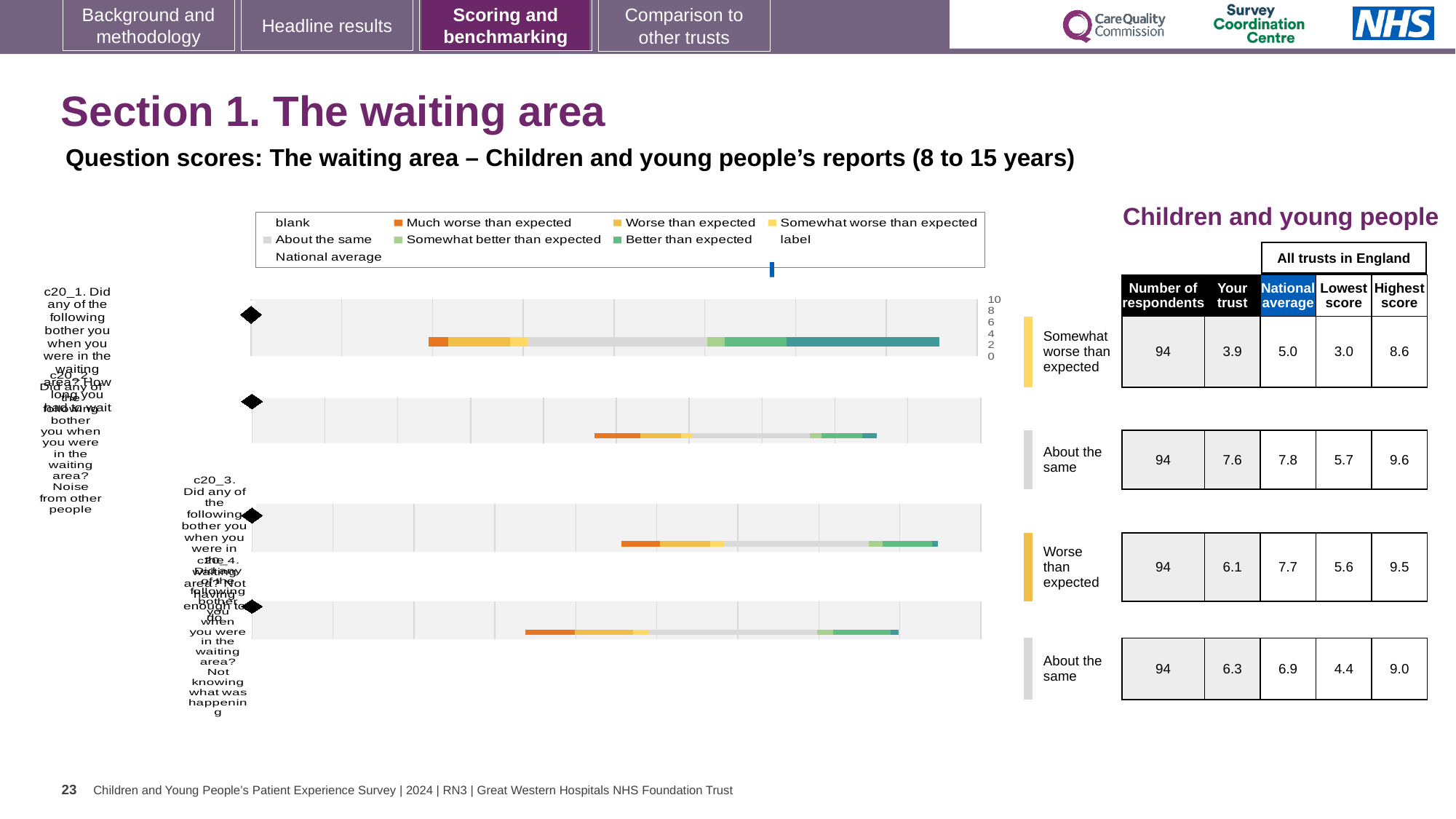
What kind of chart is used to show the score distribution for question c20_1? bar chart In the table beside the charts, what is the national average in the first row (Somewhat worse than expected)? 5.0 In the table beside the charts, what is the highest score in the last row (About the same, Your trust 6.3)? 9.0 In the chart legend, what colour represents "Much worse than expected"? orange In the table beside the charts, how many respondents are listed for the first row (Somewhat worse than expected)? 94 In the table beside the charts, which is larger in the first row: the "Your trust" score or the national average? National average In the chart legend, what colour represents "About the same"? grey In the table beside the charts, what is the lowest score in the row labelled "Worse than expected"? 5.6 What heading spans the National average, Lowest score and Highest score columns in the table beside the charts? All trusts in England In the table beside the charts, what is the difference between the highest score and the lowest score in the first row (Somewhat worse than expected)? 5.6 How many separate question charts (c20_1 to c20_4) are shown on the slide? 4 In the table beside the charts, what is the "Your trust" score in the row labelled "Worse than expected"? 6.1